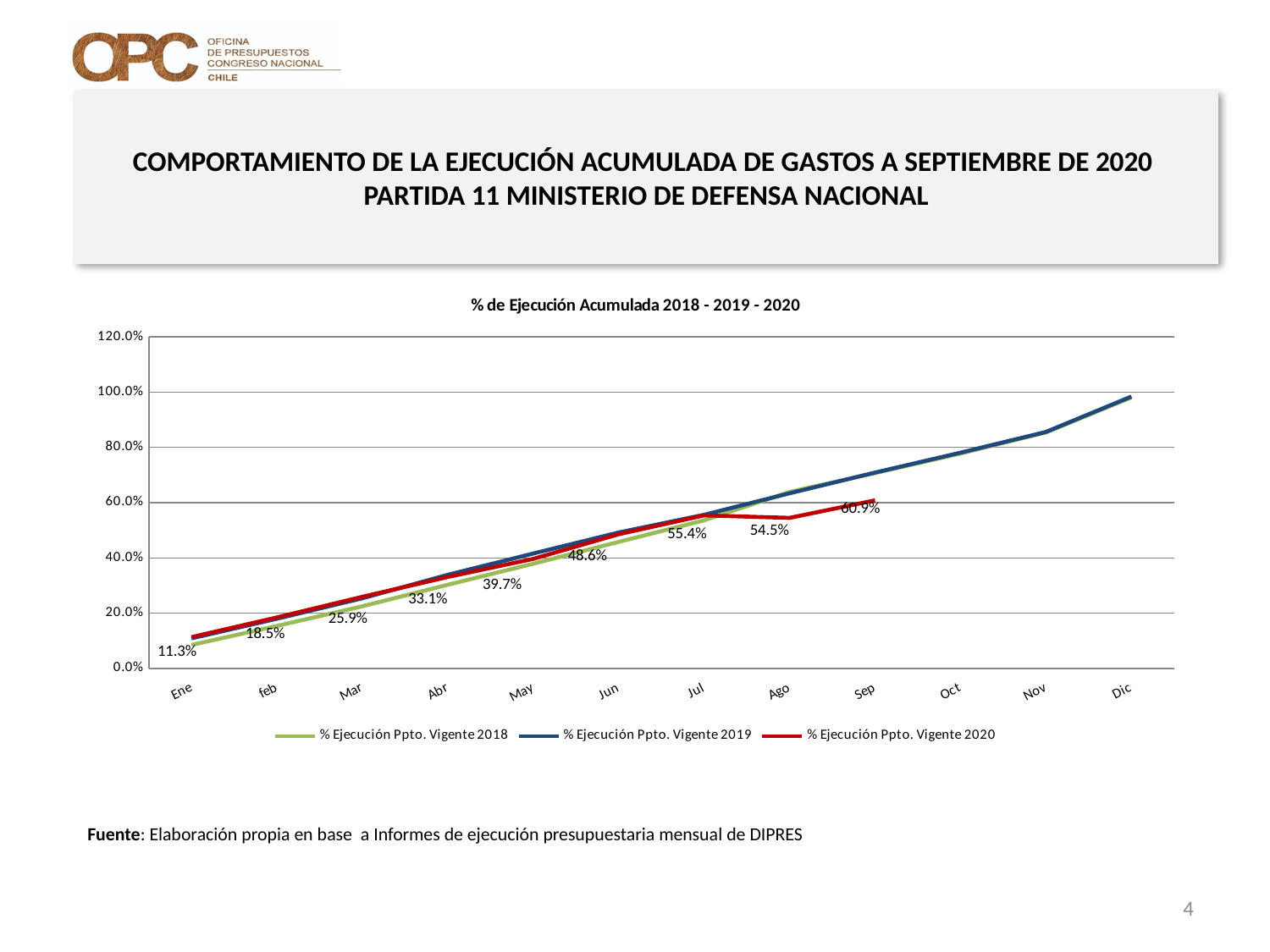
Is the value for % Ejecución Ppto. Vigente 2019 in Dic greater or less than 80.0%? greater How many months are shown along the x axis? 12 What is the value of % Ejecución Ppto. Vigente 2020 for Sep? 60.9% What is the title of the chart? % de Ejecución Acumulada 2018 - 2019 - 2020 In which month does % Ejecución Ppto. Vigente 2020 reach its lowest value? Ene What is the value of % Ejecución Ppto. Vigente 2020 for Ago? 54.5% Which of Jul or Ago has the larger value for % Ejecución Ppto. Vigente 2020? Jul What is the difference between the % Ejecución Ppto. Vigente 2020 values for Sep and Ene? 49.6% What kind of chart is shown on the slide? line chart How many series does the legend list? 3 What is the value of % Ejecución Ppto. Vigente 2020 for Ene? 11.3% What is the value of % Ejecución Ppto. Vigente 2020 for Jun? 48.6%